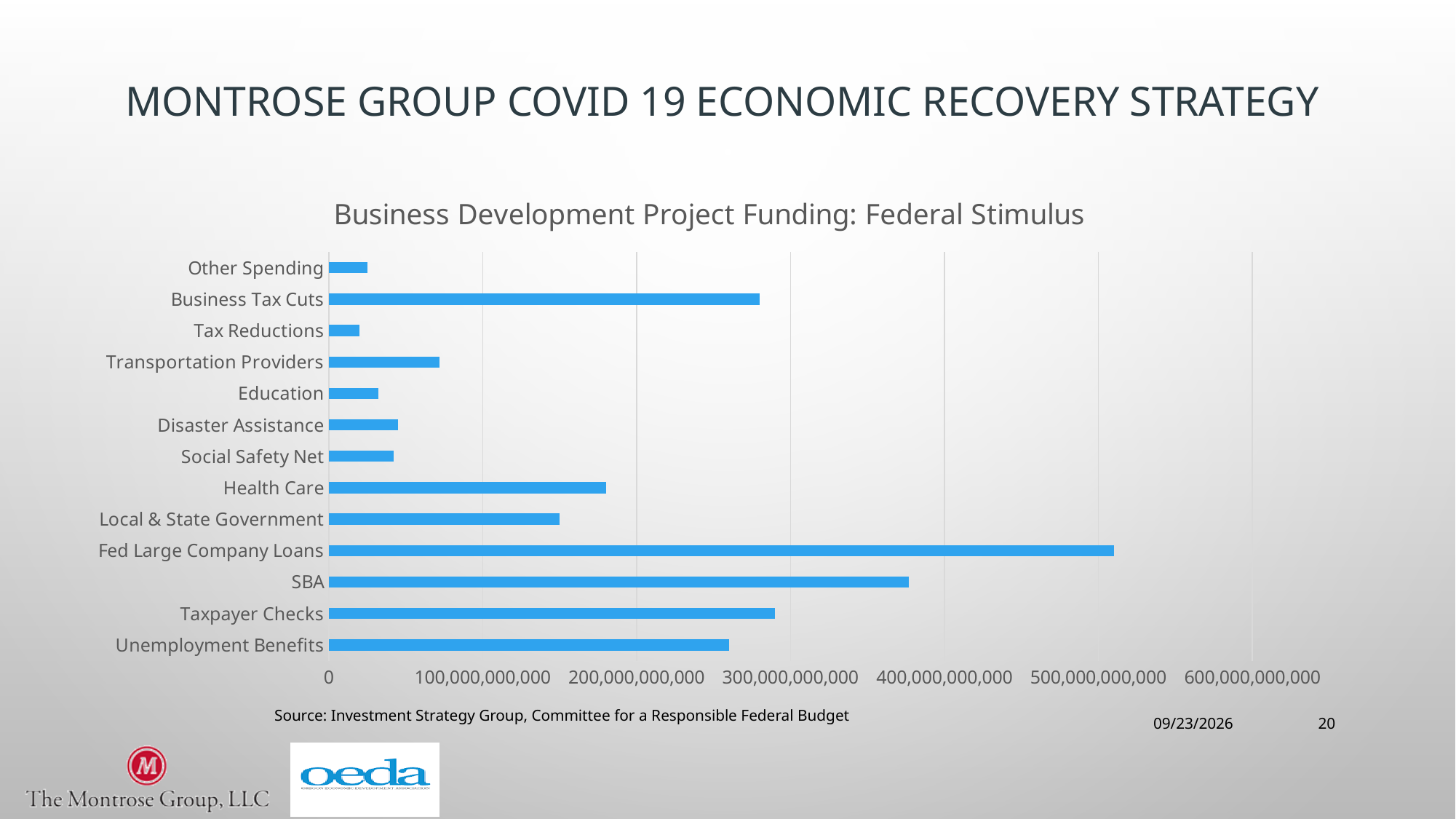
Is the value for Fed Large Company Loans greater or less than 500,000,000,000? greater Is the value for SBA greater or less than 400,000,000,000? less Is the value for Health Care greater or less than 200,000,000,000? less Which is larger, the value for Health Care or the value for Local & State Government? Health Care What source is cited below the chart? Investment Strategy Group, Committee for a Responsible Federal Budget Which is larger, the value for SBA or the value for Taxpayer Checks? SBA What kind of chart is shown on the slide? Bar chart How many categories are plotted in the chart? 13 What is the title of the chart? Business Development Project Funding: Federal Stimulus Which category has the highest value in the chart? Fed Large Company Loans